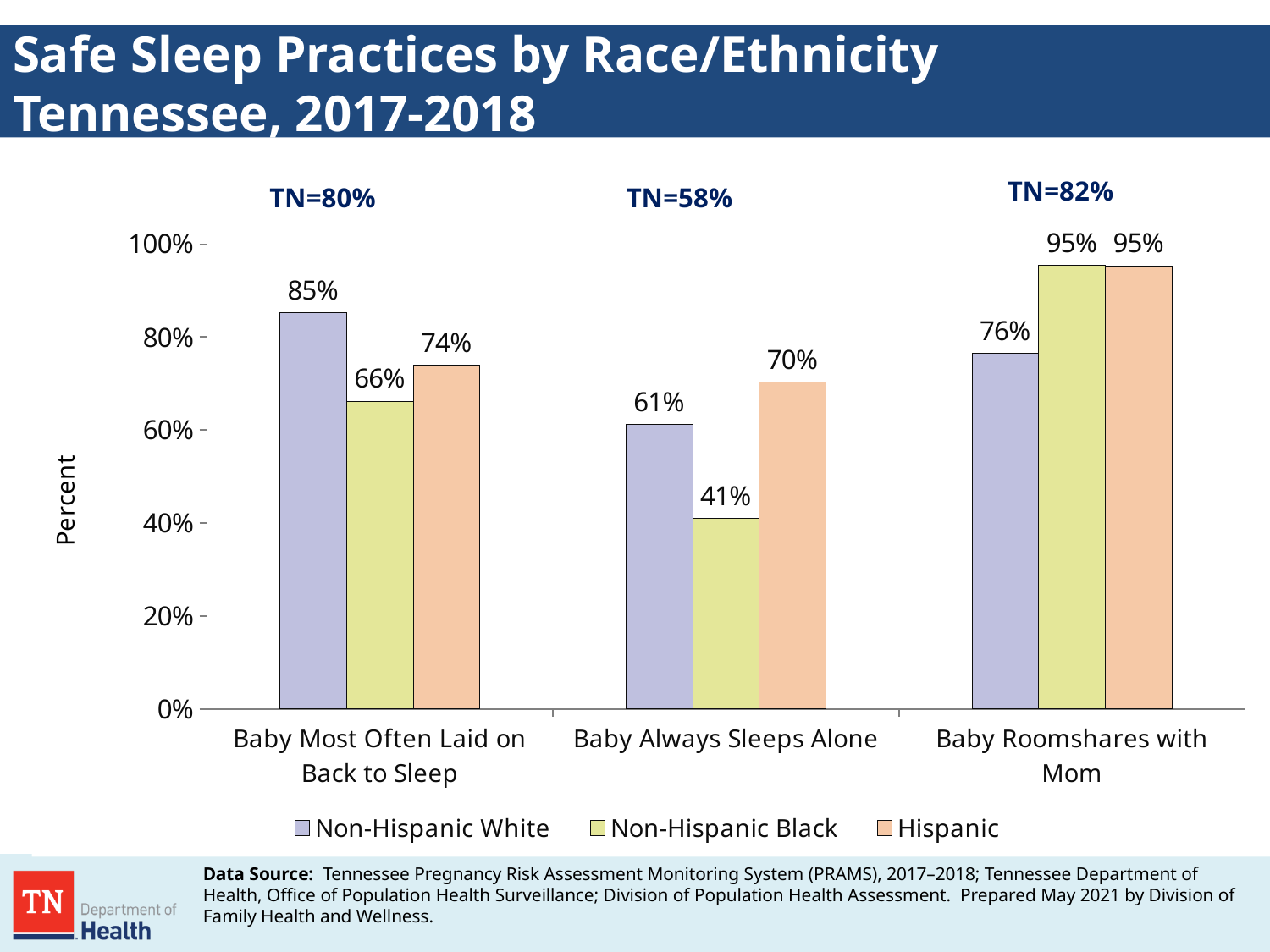
What is the value for Non-Hispanic Black for Baby Always Sleeps Alone? 41% What is the value for Hispanic for Baby Roomshares with Mom? 95% What kind of chart is shown on the slide? Bar chart Which race/ethnicity group has the highest value for Baby Most Often Laid on Back to Sleep? Non-Hispanic White What is the difference between the Hispanic and Non-Hispanic Black values for Baby Most Often Laid on Back to Sleep? 8% How many series does the legend list? 3 What is the difference between the Hispanic and Non-Hispanic White values for Baby Always Sleeps Alone? 9% What is the value for Non-Hispanic White for Baby Most Often Laid on Back to Sleep? 85% What is the Tennessee overall value (TN=) shown above the Baby Always Sleeps Alone group? TN=58% How many safe sleep practice categories are shown on the x axis? 3 Which is larger for Baby Roomshares with Mom: the Non-Hispanic White value or the Non-Hispanic Black value? Non-Hispanic Black Which race/ethnicity group has the lowest value for Baby Always Sleeps Alone? Non-Hispanic Black